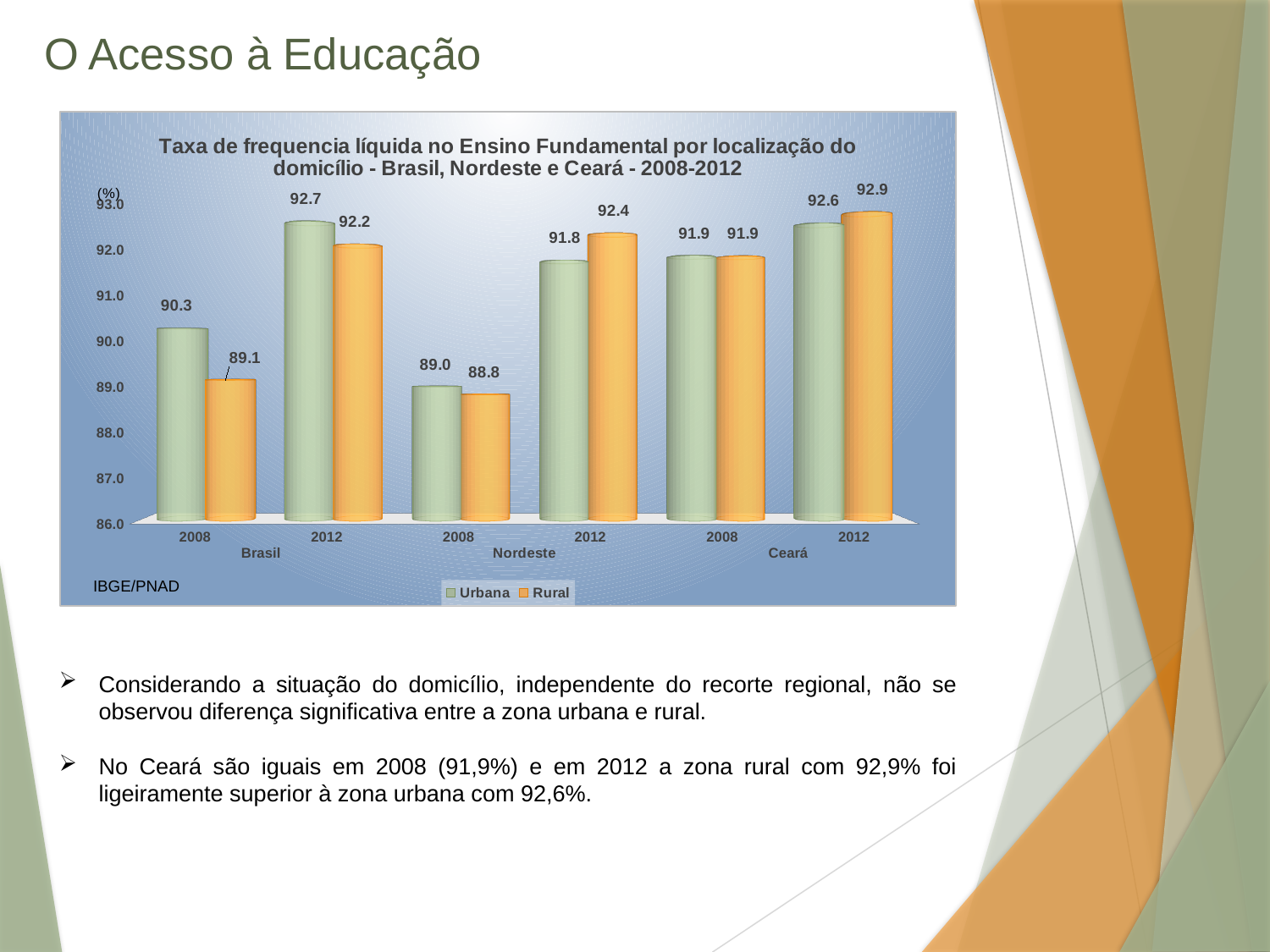
What is the Rural value for Nordeste in 2012? 92.4 What is the data source shown at the bottom left of the chart? IBGE/PNAD What kind of chart is shown on the slide? Bar chart Is the Urbana value for Nordeste in 2008 greater or less than 90.0? less Which is larger for Brasil in 2008, the Urbana value or the Rural value? Urbana How many bars are plotted on the chart? 12 What is the Urbana value for Brasil in 2008? 90.3 What is the difference between the Urbana and Rural values for Brasil in 2012? 0.5 Which bar has the lowest value on the chart? Rural, Nordeste 2008 (88.8) Which bar has the highest value on the chart? Rural, Ceará 2012 (92.9) What is the Rural value for Ceará in 2012? 92.9 How many series does the legend list? 2